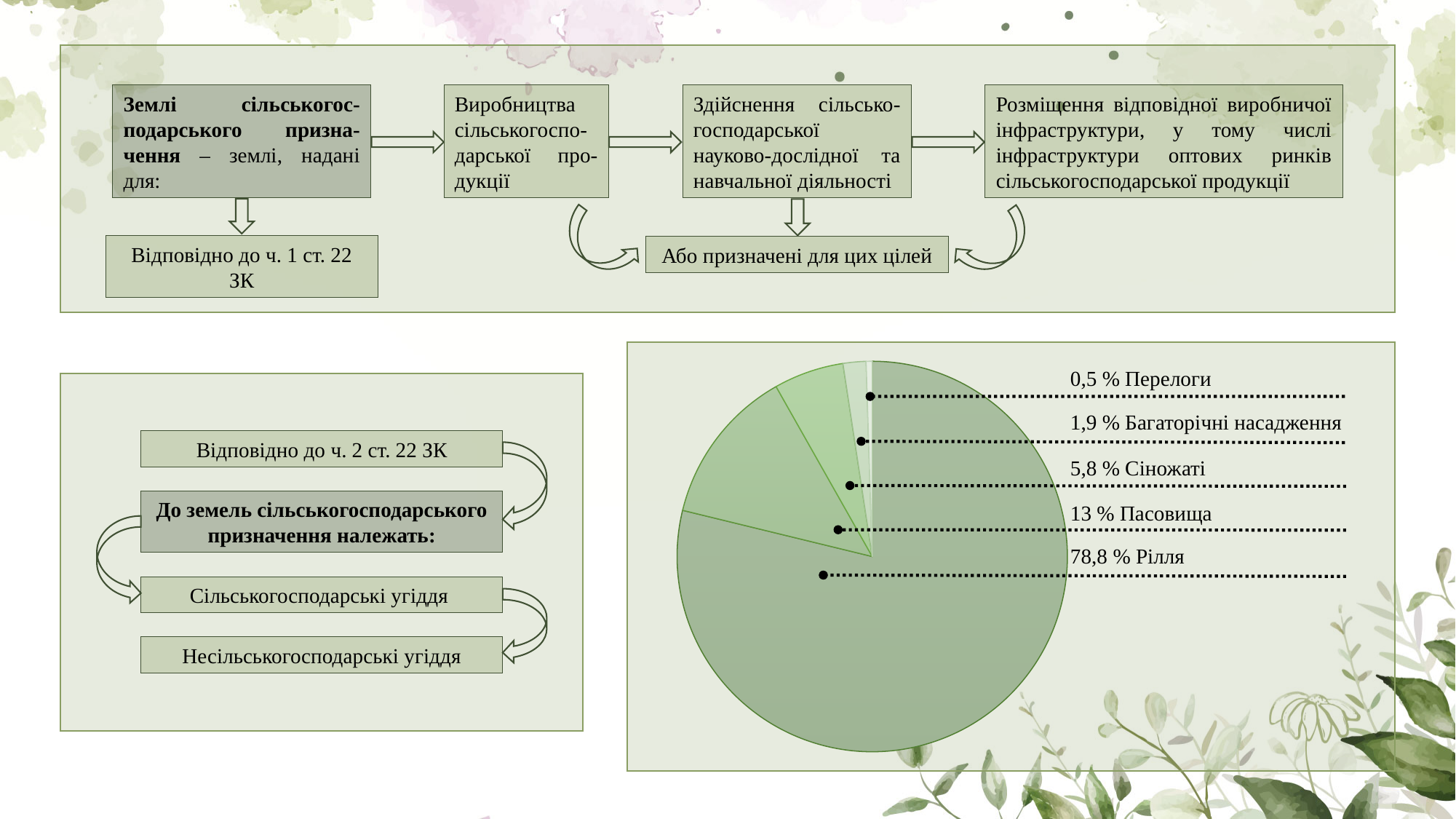
What share of the pie chart is labelled Сіножаті? 5,8 % What share of the pie chart is labelled Багаторічні насадження? 1,9 % Which category has the largest slice in the pie chart? Рілля What kind of chart is shown on the slide? pie chart What share of the pie chart is labelled Перелоги? 0,5 % How many slices does the pie chart have? 5 What is the difference in percentage points between Сіножаті and Багаторічні насадження in the pie chart? 3,9 What share of the pie chart is labelled Пасовища? 13 % What is the difference in percentage points between Рілля and Пасовища in the pie chart? 65,8 What share of the pie chart is labelled Рілля? 78,8 % Which category has the smallest slice in the pie chart? Перелоги Which is larger in the pie chart, Пасовища or Сіножаті? Пасовища